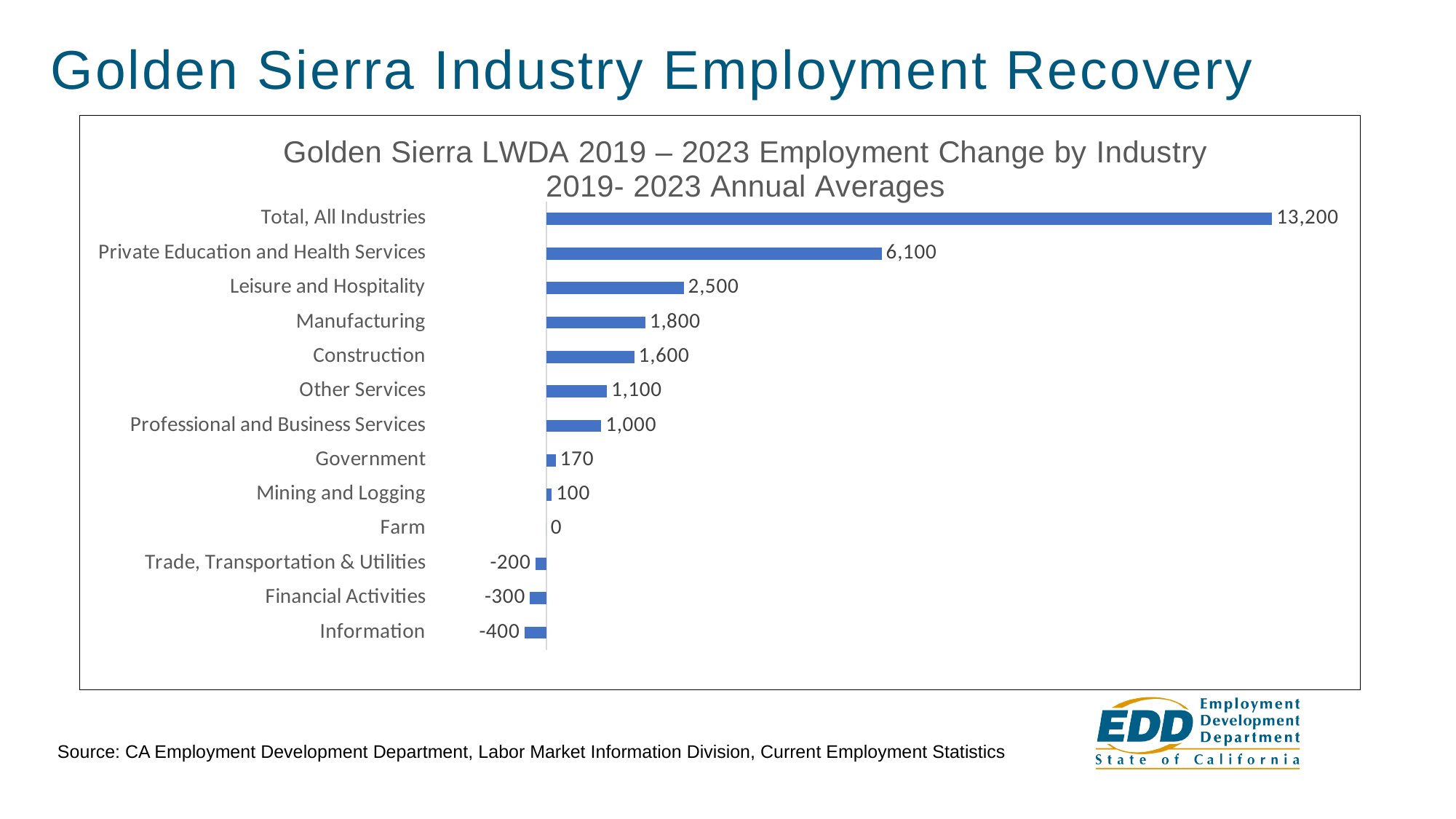
What is the employment change for Farm? 0 What is the employment change for Manufacturing? 1,800 What is the difference between the employment change for Leisure and Hospitality and for Construction? 900 What is the title of the chart? Golden Sierra LWDA 2019 – 2023 Employment Change by Industry 2019- 2023 Annual Averages What is the employment change for Private Education and Health Services? 6,100 What is the employment change for Government? 170 Which industry has the lowest employment change? Information What kind of chart is shown on the slide? Bar chart How many categories are shown in the chart? 13 What is the employment change for Information? -400 Which has a larger employment change, Other Services or Professional and Business Services? Other Services Which category has the highest employment change? Total, All Industries